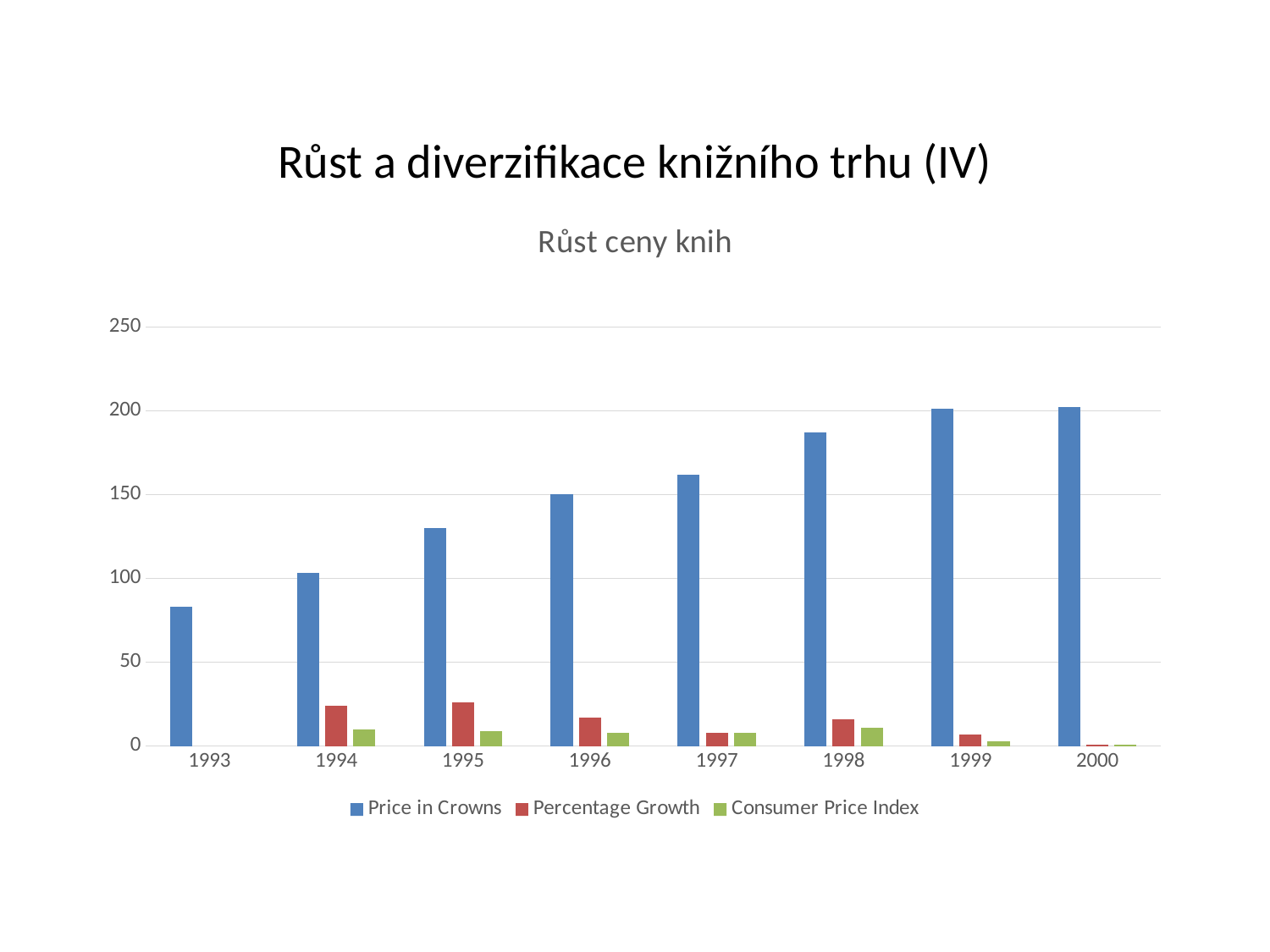
What kind of chart is shown on the slide? bar chart Is the value for Price in Crowns in 1998 greater or less than 150? greater Which year has the highest value for Percentage Growth? 1995 Does the Price in Crowns series rise or fall from 1993 to 2000? rise How many years are shown on the x axis? 8 How many series does the legend list? 3 Is the value for Percentage Growth in 1994 greater or less than 50? less Which is larger, the Price in Crowns in 1996 or in 1994? 1996 Is the value for Price in Crowns in 1993 greater or less than 100? less Which year has the lowest value for Price in Crowns? 1993 What is the title of the chart? Růst ceny knih